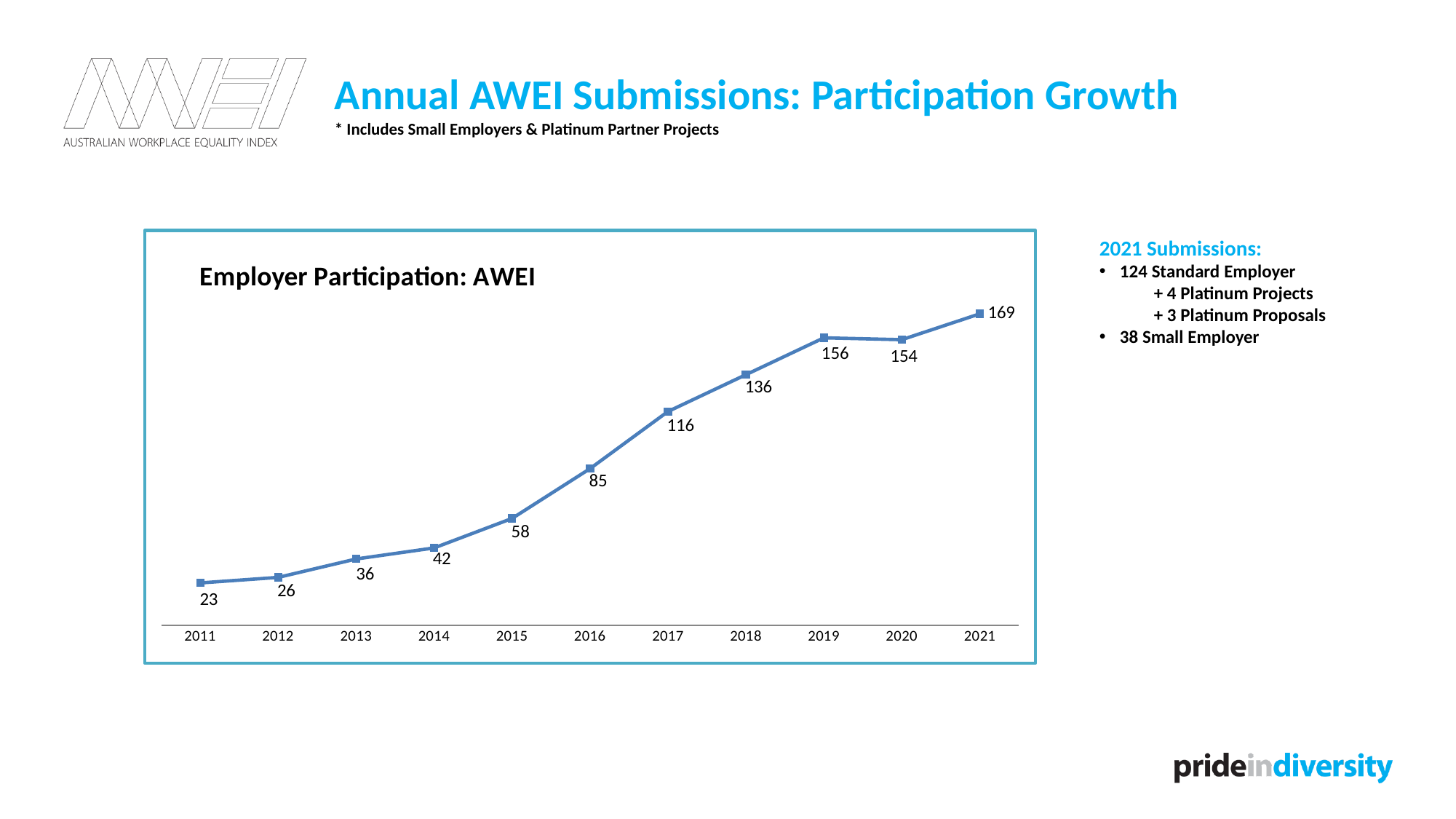
What is the value for 2019 in the Employer Participation: AWEI chart? 156 Which is larger in the Employer Participation: AWEI chart, the value for 2019 or the value for 2020? 2019 What is the value for 2011 in the Employer Participation: AWEI chart? 23 What is the difference between the values for 2017 and 2016 in the Employer Participation: AWEI chart? 31 Which year has the lowest value in the Employer Participation: AWEI chart? 2011 What is the title of the chart on the slide? Employer Participation: AWEI What is the difference between the values for 2021 and 2020 in the Employer Participation: AWEI chart? 15 Which year has the highest value in the Employer Participation: AWEI chart? 2021 What kind of chart is the Employer Participation: AWEI chart? line chart How many years are plotted in the Employer Participation: AWEI chart? 11 Do the values in the Employer Participation: AWEI chart generally rise or fall from 2011 to 2021? rise What is the value for 2015 in the Employer Participation: AWEI chart? 58